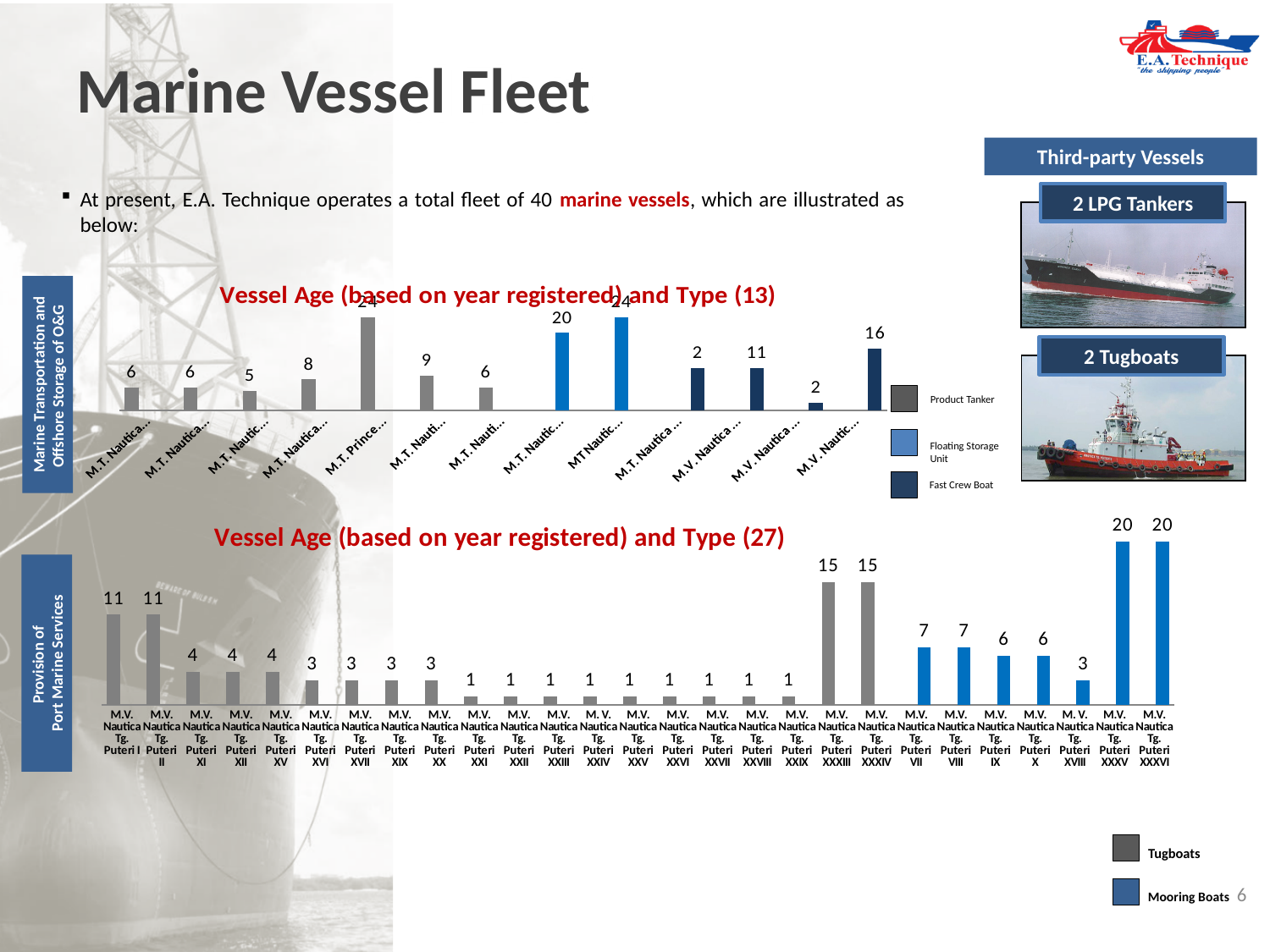
In the bottom chart, 'Vessel Age (based on year registered) and Type (27)', what is the value for M.V. Nautica Tg. Puteri XVIII? 3 What is the highest value shown in the top chart, 'Vessel Age (based on year registered) and Type (13)'? 24 In the bottom chart, 'Vessel Age (based on year registered) and Type (27)', what is the difference between the values for M.V. Nautica Tg. Puteri I and M.V. Nautica Tg. Puteri XI? 7 How many series does the legend of the bottom chart, 'Vessel Age (based on year registered) and Type (27)', list? 2 In the bottom chart, 'Vessel Age (based on year registered) and Type (27)', which is larger: the value for M.V. Nautica Tg. Puteri XXXIV or the value for M.V. Nautica Tg. Puteri IX? M.V. Nautica Tg. Puteri XXXIV What kind of chart is the top chart, 'Vessel Age (based on year registered) and Type (13)'? Bar chart In the bottom chart, 'Vessel Age (based on year registered) and Type (27)', what is the highest value shown? 20 How many bars are plotted in the top chart, 'Vessel Age (based on year registered) and Type (13)'? 13 How many series does the legend of the top chart, 'Vessel Age (based on year registered) and Type (13)', list? 3 In the bottom chart, 'Vessel Age (based on year registered) and Type (27)', what is the value for M.V. Nautica Tg. Puteri VII? 7 In the bottom chart, 'Vessel Age (based on year registered) and Type (27)', what is the value for M.V. Nautica Tg. Puteri XXXIII? 15 How many bars are plotted in the bottom chart, 'Vessel Age (based on year registered) and Type (27)'? 27